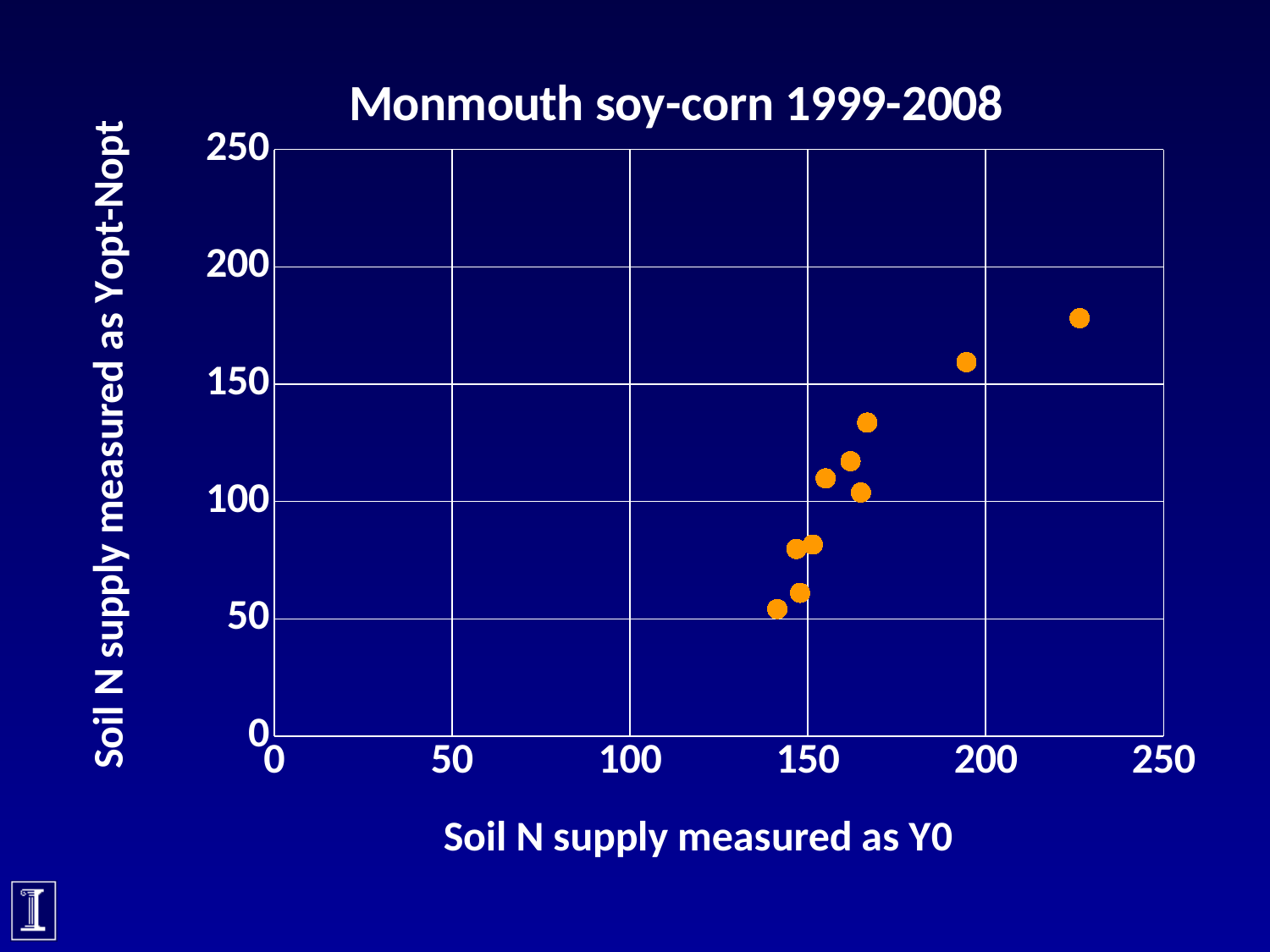
Is the x value of the rightmost point greater or less than 200? greater Is the y value of the lowest point greater or less than 100? less What is the maximum value shown on the y axis? 250 What is the title of the chart? Monmouth soy-corn 1999-2008 How many points have a y value greater than 150? 2 Do the y values generally rise or fall as the x values increase? rise How many points have an x value greater than 200? 1 What kind of chart is shown on the slide? scatter chart How many data points are plotted on the chart? 10 Is the y value of the rightmost point greater or less than 150? greater What is the label of the x axis? Soil N supply measured as Y0